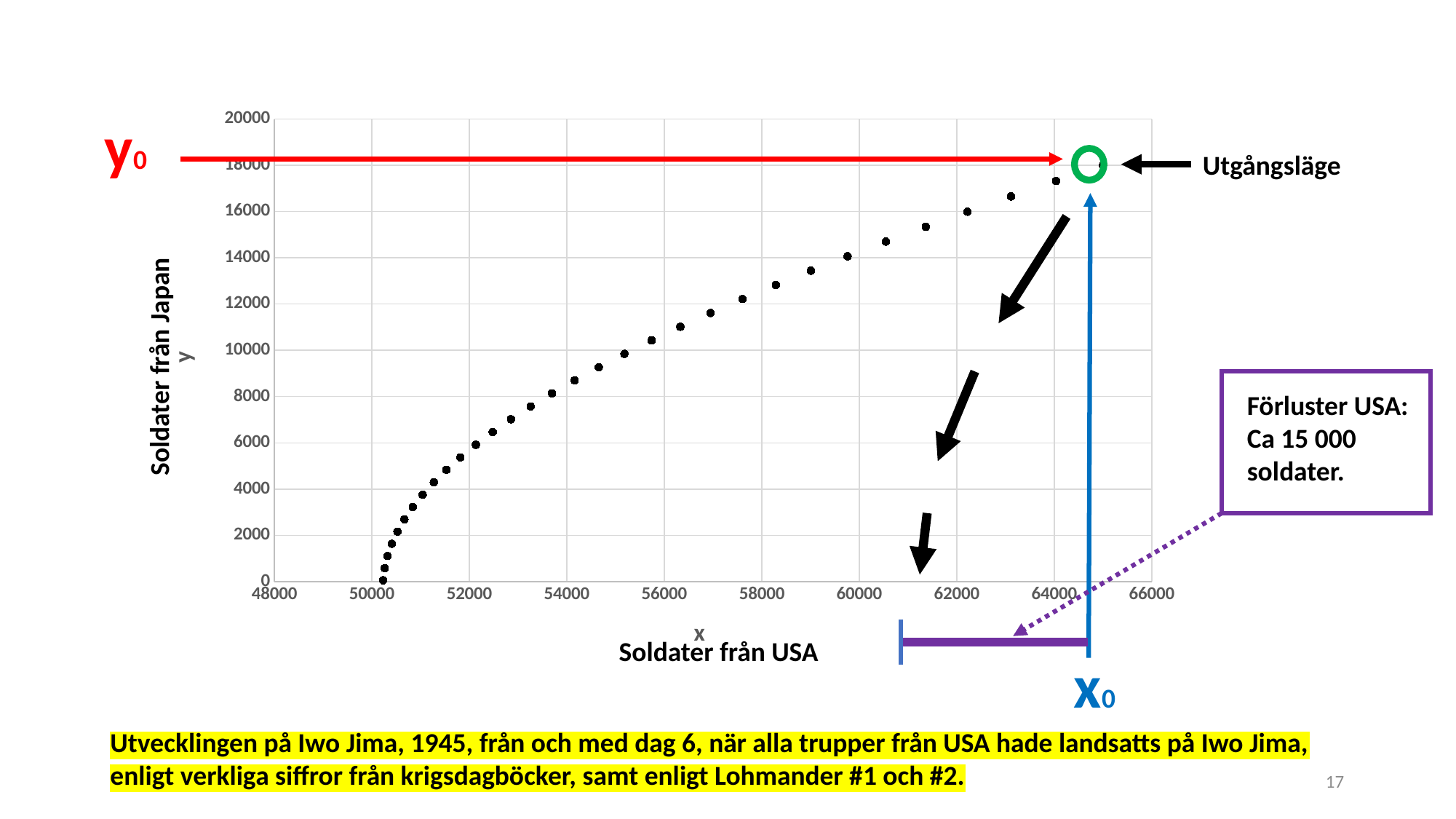
What is the title of the horizontal axis? Soldater från USA Is the Soldater från Japan value at the point marked Utgångsläge greater or less than 16000? greater What kind of chart is shown on the slide? scatter chart What is the highest tick value shown on the vertical axis? 20000 Do the plotted values of Soldater från Japan rise or fall as Soldater från USA increases along the x axis? rise What is the title of the vertical axis? Soldater från Japan Is the Soldater från USA value of the lowest plotted point (where Soldater från Japan is near 0) greater or less than 52000? less Which point has the higher Soldater från Japan value: the point marked Utgångsläge or the point at the bottom of the curve near 50000 on the x axis? the point marked Utgångsläge Is the Soldater från USA value at the point marked Utgångsläge greater or less than 64000? greater